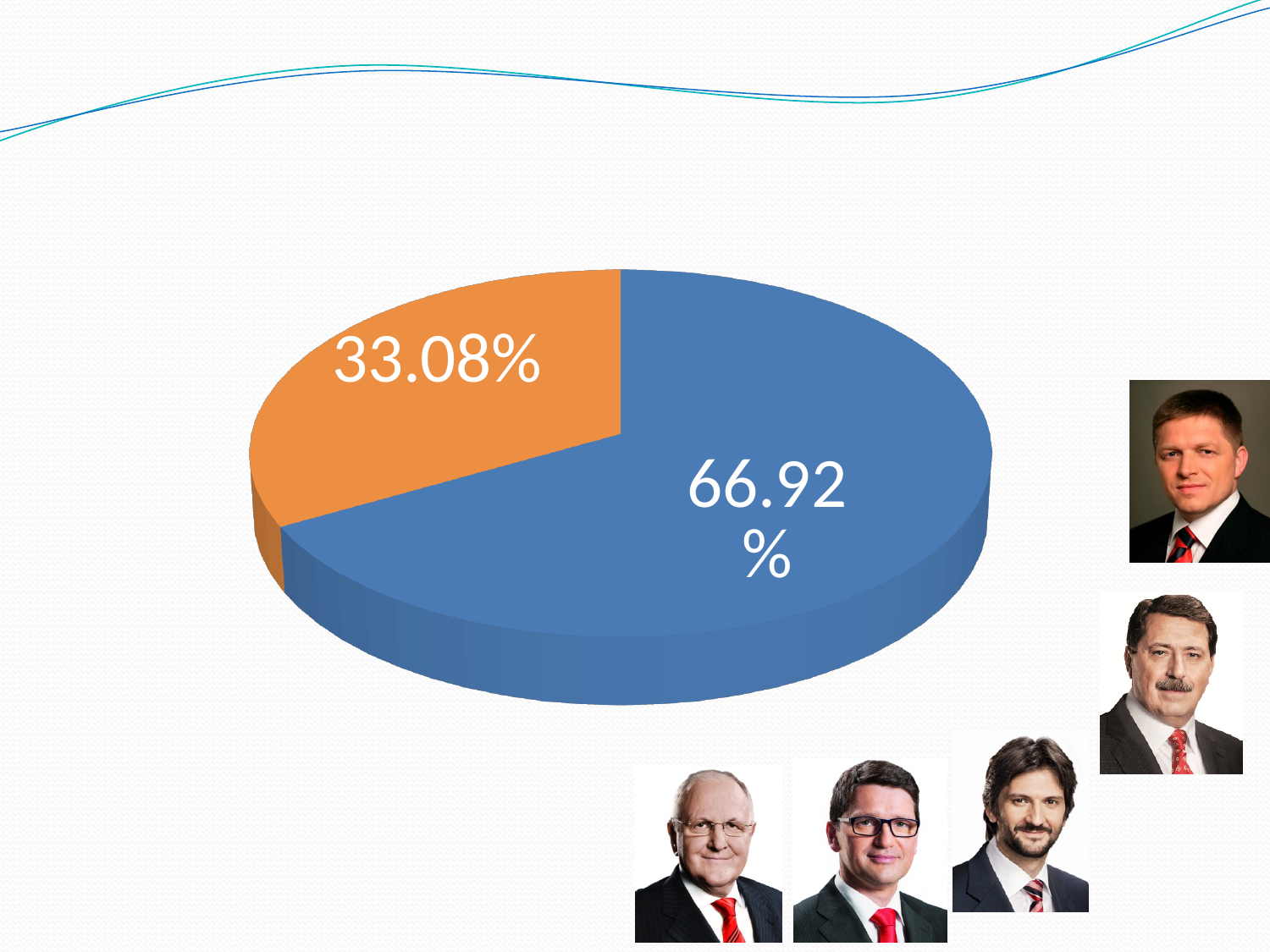
How many slices does the pie chart have? 2 Which slice of the pie chart is the smallest? the orange slice What percentage is shown on the orange slice of the pie chart? 33.08% What colours are the two slices of the pie chart? blue and orange What is the difference between the blue slice's percentage and the orange slice's percentage? 33.84% What percentage is shown on the blue slice of the pie chart? 66.92% Is the orange slice's share of the pie greater or less than 50%? less Which slice of the pie chart is the largest? the blue slice Is the blue slice's share of the pie greater or less than 50%? greater Which is larger, the blue slice or the orange slice? the blue slice What share of the pie does the orange slice represent? 33.08% What kind of chart is shown on the slide? pie chart